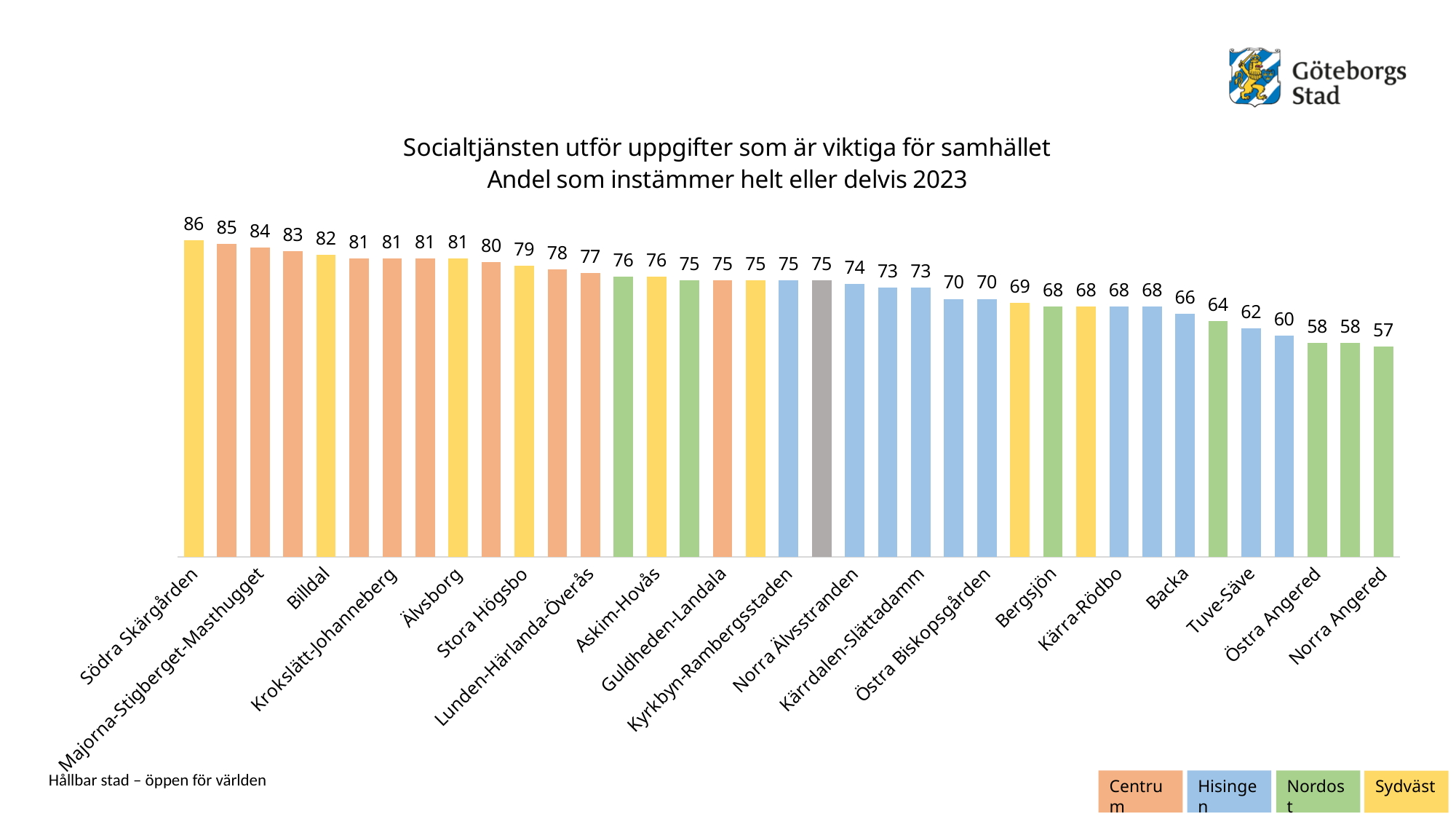
Which category has the highest value? Södra Skärgården What kind of chart is shown on the slide? Bar chart Which category has the lowest value? Norra Angered What is the difference between the values for Södra Skärgården and Norra Angered? 29 Which is larger, the value for Billdal or the value for Tuve-Säve? Billdal How many bars are plotted in the chart? 37 Do the values rise or fall from left to right along the x axis? Fall What is the value for Bergsjön? 68 What is the value for Norra Angered? 57 How many entries does the legend list? 4 What is the value for Södra Skärgården? 86 What is the value for Backa? 66